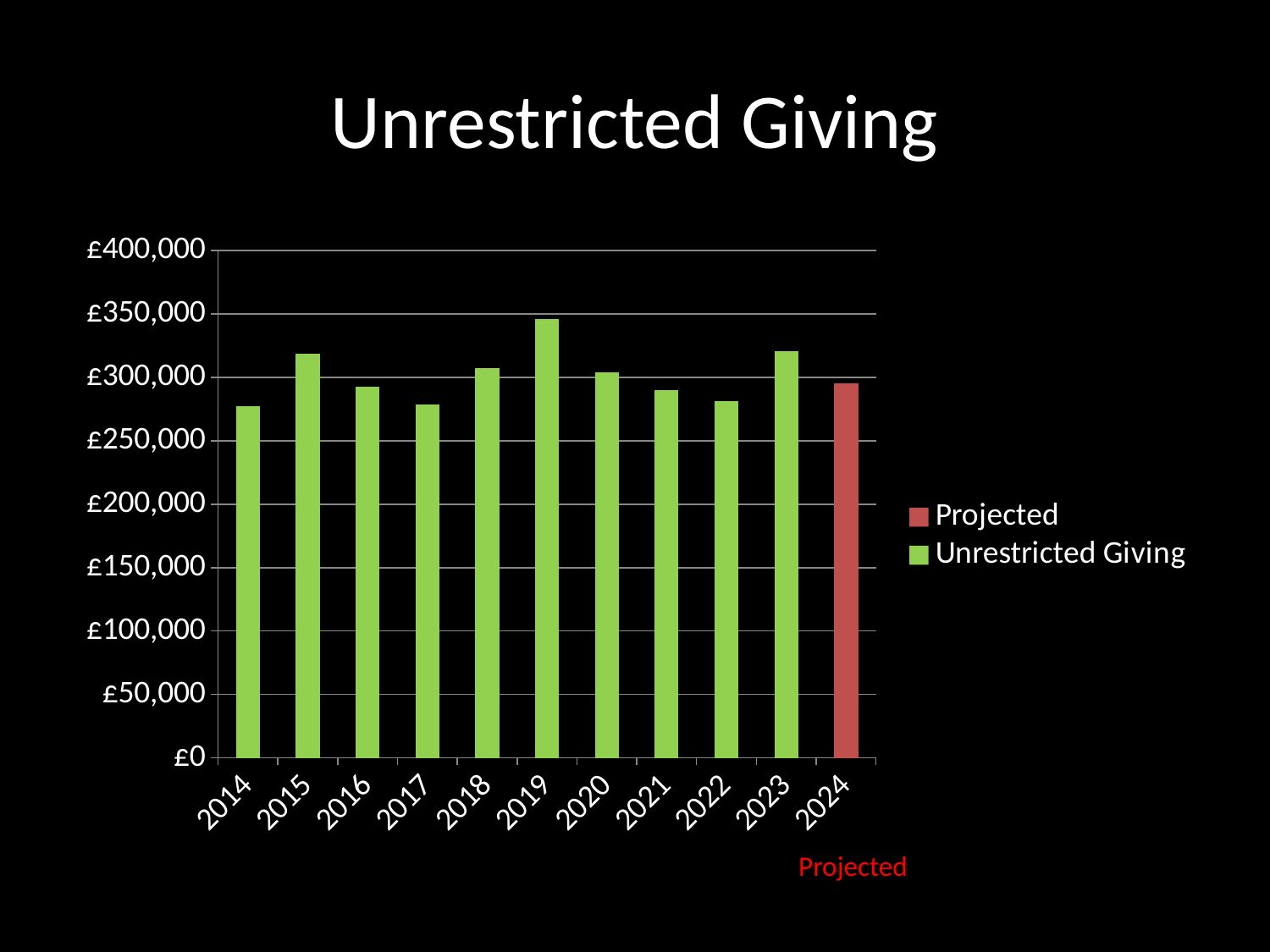
Which year's bar is shown in red rather than green? 2024 Which is larger, the value for 2015 or the value for 2016? 2015 Which is larger, the value for 2018 or the value for 2022? 2018 Is the value for 2023 greater or less than £300,000? greater Is the value for 2022 greater or less than £300,000? less Is the value for 2014 greater or less than £250,000? greater How many series does the legend list? 2 Which year has the highest unrestricted giving? 2019 How many years are shown on the x axis? 11 What kind of chart is shown on the slide? bar chart What is the title of the chart? Unrestricted Giving